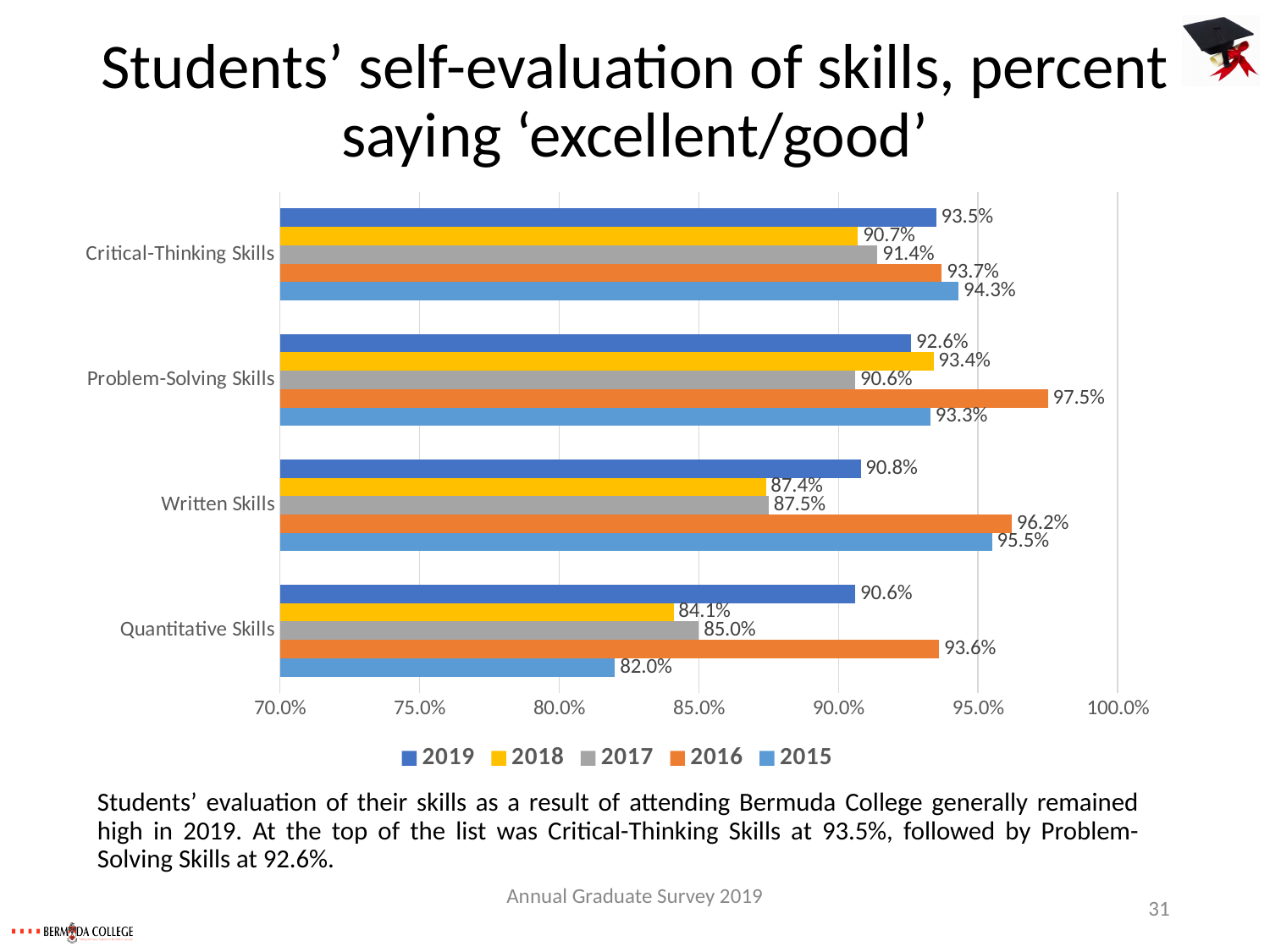
Which skill category has the highest 2019 value? Critical-Thinking Skills How many series does the legend list? 5 What is the 2016 value for Problem-Solving Skills? 97.5% What kind of chart is shown on the slide? Bar chart For Quantitative Skills, which is larger: the 2019 value or the 2017 value? 2019 Which year is shown in orange in the legend? 2016 Is the 2015 value for Written Skills greater or less than 95.0%? greater What is the 2015 value for Quantitative Skills? 82.0% Which skill category has the lowest 2018 value? Quantitative Skills How many skill categories are plotted on the chart? 4 What is the 2019 value for Critical-Thinking Skills? 93.5% What is the difference between the 2016 and 2019 values for Written Skills? 5.4%